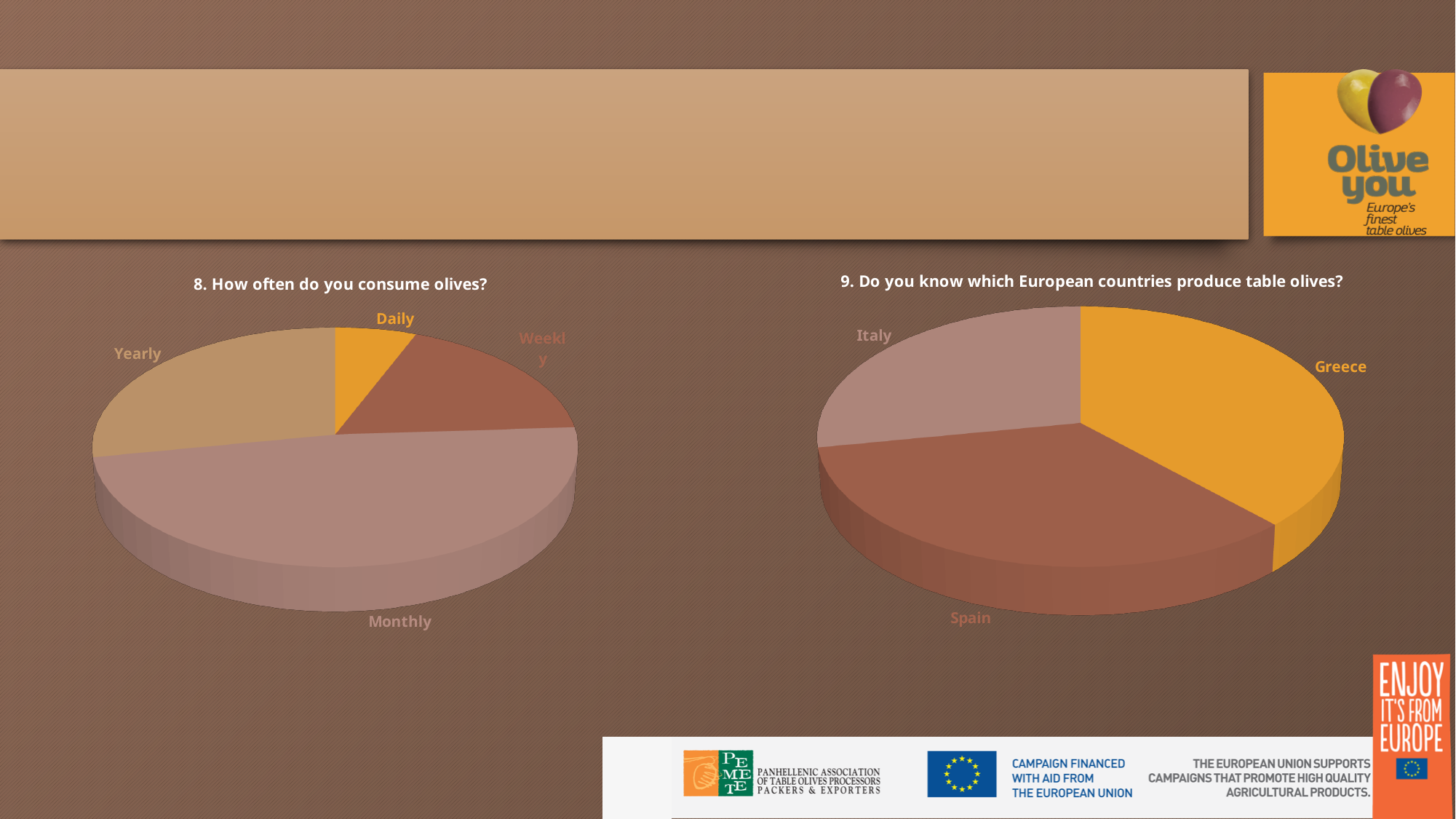
In the chart "8. How often do you consume olives?", which category has the largest slice? Monthly In the chart "8. How often do you consume olives?", which category has the smallest slice? Daily In the chart "9. Do you know which European countries produce table olives?", which country has the largest slice? Greece What is the title of the pie chart on the left of the slide? 8. How often do you consume olives? In the chart "9. Do you know which European countries produce table olives?", which slice is larger, Spain or Italy? Spain What kind of chart is used for "8. How often do you consume olives?"? pie chart In the chart "8. How often do you consume olives?", how many slices does the pie have? 4 In the chart "8. How often do you consume olives?", which slice is larger, Monthly or Yearly? Monthly What kind of chart is used for "9. Do you know which European countries produce table olives?"? pie chart In the chart "9. Do you know which European countries produce table olives?", which country's slice is coloured yellow-orange? Greece In the chart "9. Do you know which European countries produce table olives?", how many countries are shown? 3 In the chart "8. How often do you consume olives?", which slice is larger, Daily or Weekly? Weekly